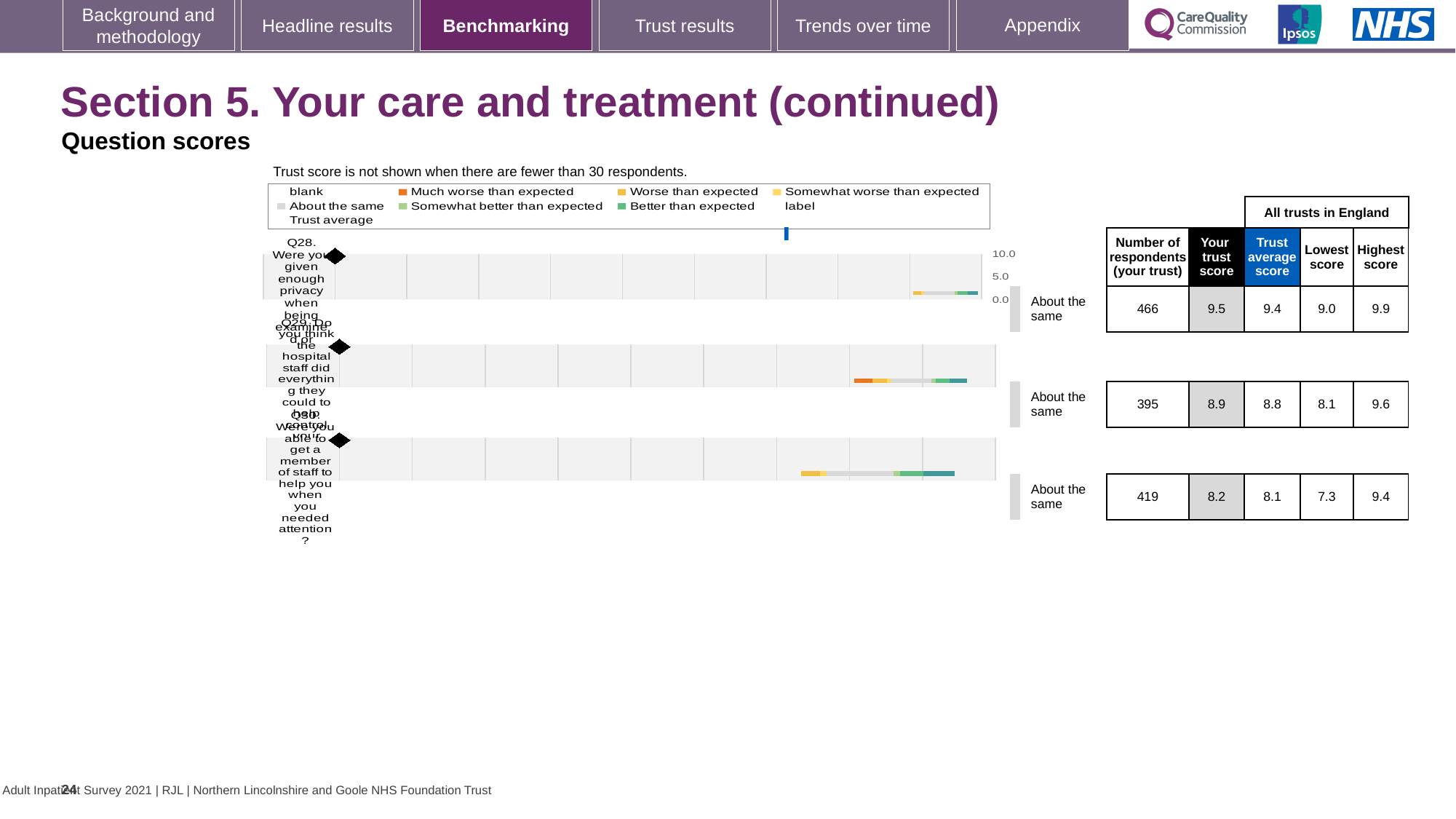
In the table beside the chart, what is the number of respondents for Q28? 466 What is the difference between the highest score and the lowest score for Q30 in the table beside the chart? 2.1 What is the highest value shown on the chart's score axis? 10.0 In the table beside the chart, what is the trust average score for Q30? 8.1 In the table beside the chart, what is the lowest score across all trusts in England for Q30? 7.3 Which question has the highest trust score in the table beside the chart? Q28 What kind of chart is shown on the slide? bar chart What benchmark category label is shown next to each of the three questions in the chart? About the same Which question has the lowest number of respondents in the table beside the chart? Q29 In the table beside the chart, what is the trust score for Q29? 8.9 In the table beside the chart, what is the highest score across all trusts in England for Q28? 9.9 How many questions (categories) are plotted in the chart? 3